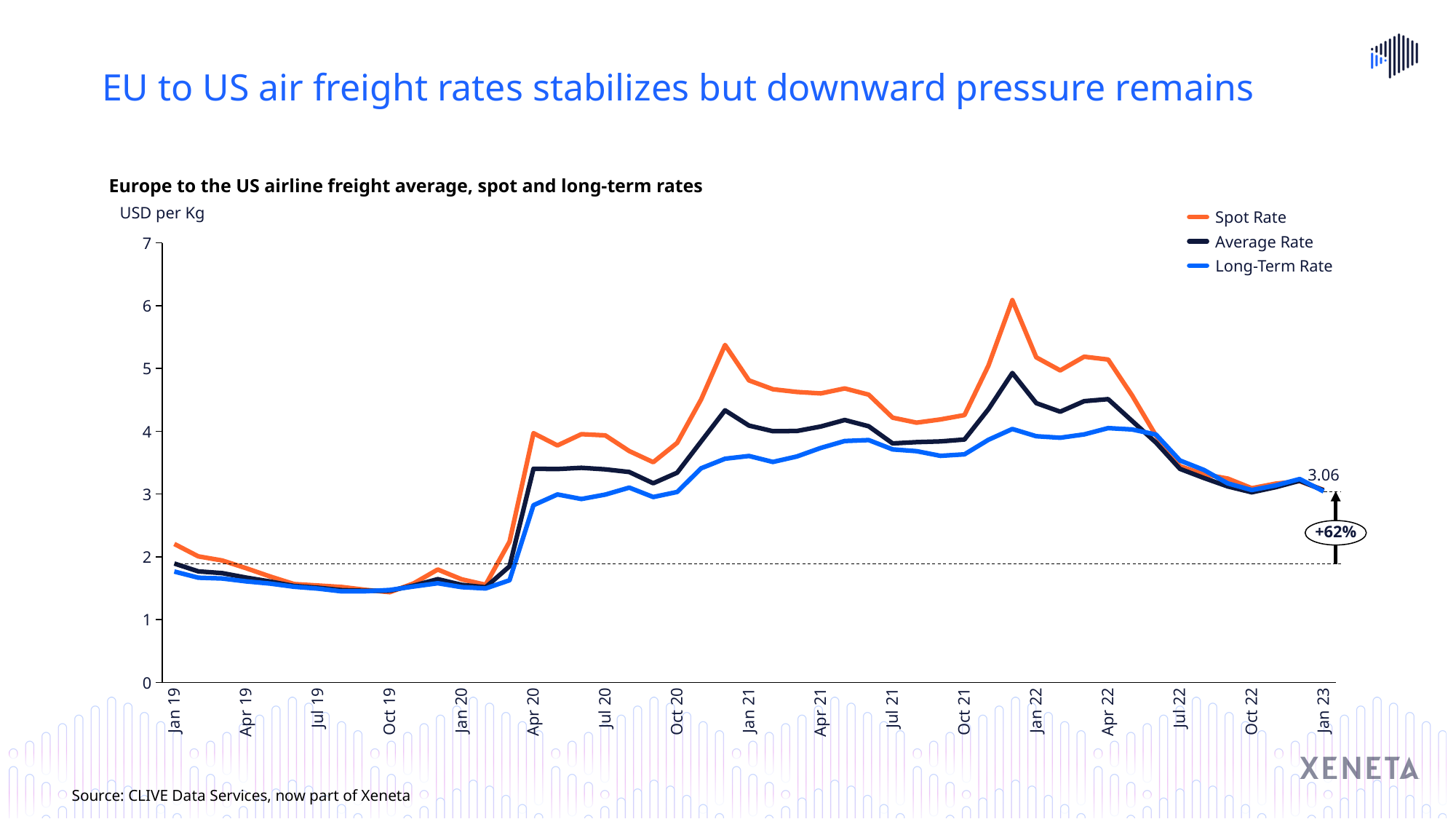
Is the Long-Term Rate at Jan 19 greater or less than 2? less What are the three series listed in the legend? Spot Rate, Average Rate, Long-Term Rate Between Jan 20 and Apr 20, do the rates rise or fall? rise What type of chart is shown on the slide? line chart Is the Average Rate at Oct 19 greater or less than 2? less How many series does the legend list? 3 What percentage change is shown in the annotation at the right of the chart? +62% What value is labelled at the end of the chart at Jan 23? 3.06 Is the peak value of the Spot Rate greater or less than 5? greater Between Apr 22 and Oct 22, do the rates rise or fall? fall Which series reaches the highest value on the chart? Spot Rate At Jan 22, which is higher, the Spot Rate or the Long-Term Rate? Spot Rate